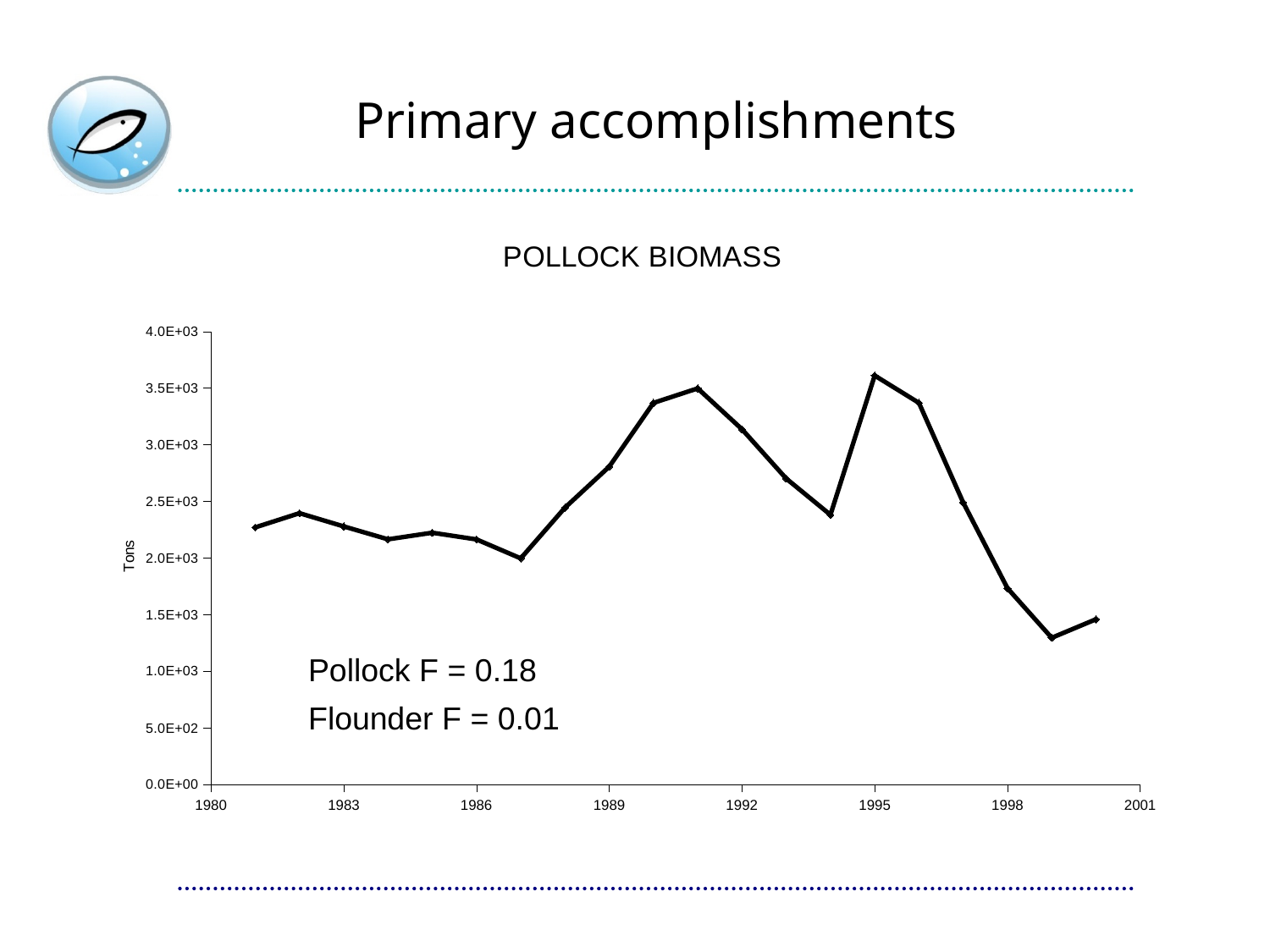
Is the pollock biomass in 1991 greater or less than 3.0E+03 tons? greater Is the pollock biomass in 1989 greater or less than 2.5E+03 tons? greater Does the pollock biomass rise or fall between 1987 and 1991? rise In which year does the pollock biomass reach its lowest value? 1999 What is the label on the y axis of the chart? Tons In which year does the pollock biomass reach its highest value? 1995 Which year has the larger pollock biomass, 1990 or 1993? 1990 Does the pollock biomass rise or fall between 1996 and 1999? fall What is the title of the chart? POLLOCK BIOMASS What kind of chart is shown on the slide? line chart Is the pollock biomass in 1999 greater or less than 1.5E+03 tons? less